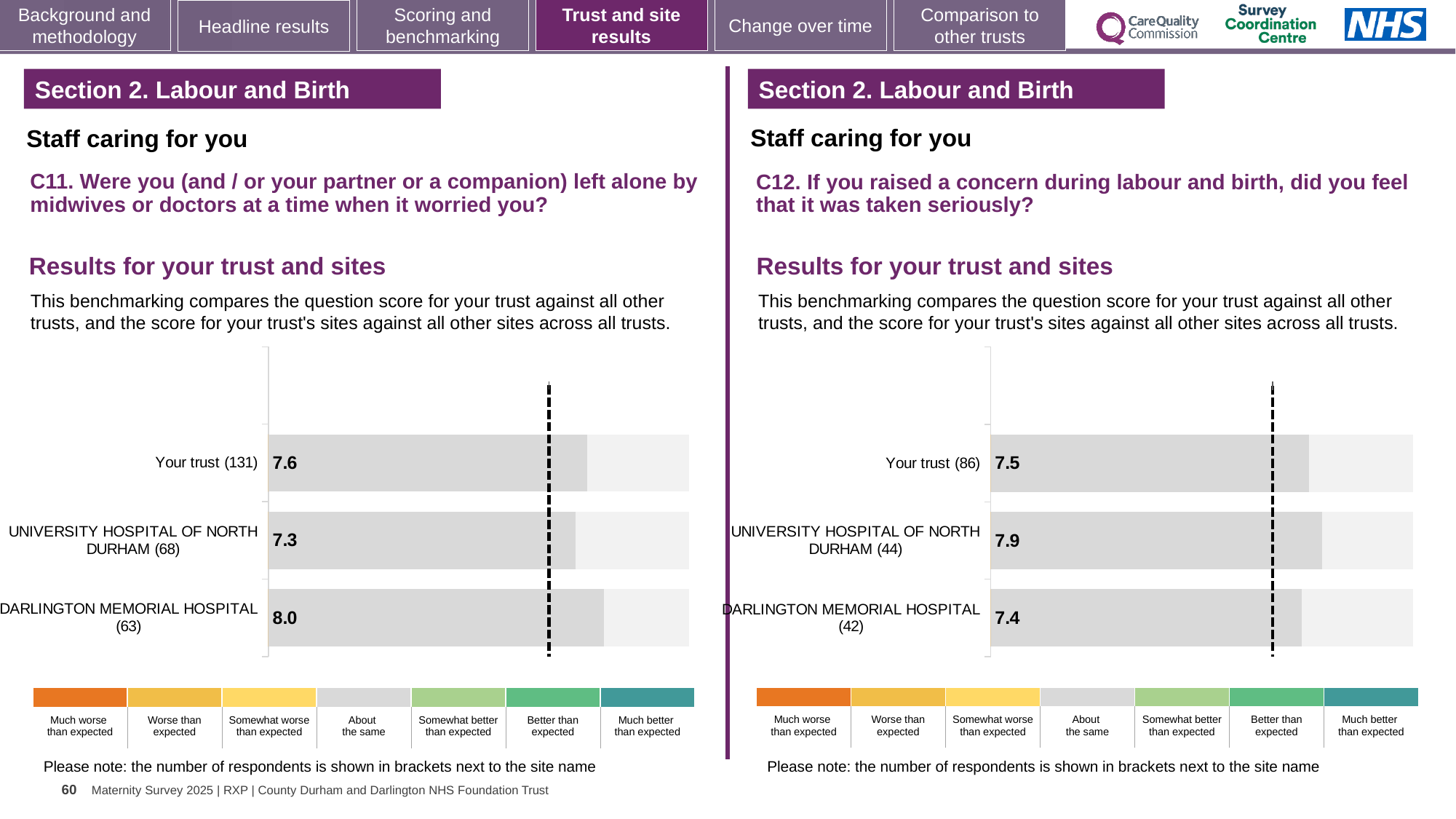
In the C11 chart (left), what is the score for DARLINGTON MEMORIAL HOSPITAL (63)? 8.0 In the C11 chart (left), which site or trust has the lowest score? UNIVERSITY HOSPITAL OF NORTH DURHAM (68) What kind of chart is used in the C12 chart (right)? Bar chart In the C12 chart (right), what is the score for UNIVERSITY HOSPITAL OF NORTH DURHAM (44)? 7.9 In the C12 chart (right), which site or trust has the highest score? UNIVERSITY HOSPITAL OF NORTH DURHAM (44) How many bars are shown in the C11 chart (left)? 3 In the C11 chart (left), what is the difference between the scores for DARLINGTON MEMORIAL HOSPITAL (63) and UNIVERSITY HOSPITAL OF NORTH DURHAM (68)? 0.7 In the C12 chart (right), which is larger, the score for Your trust (86) or the score for DARLINGTON MEMORIAL HOSPITAL (42)? Your trust (86) In the C11 chart (left), what is the score for Your trust (131)? 7.6 In the C12 chart (right), what is the difference between the scores for UNIVERSITY HOSPITAL OF NORTH DURHAM (44) and DARLINGTON MEMORIAL HOSPITAL (42)? 0.5 In the C12 chart (right), what is the score for Your trust (86)? 7.5 In the C11 chart (left), which site or trust has the highest score? DARLINGTON MEMORIAL HOSPITAL (63)